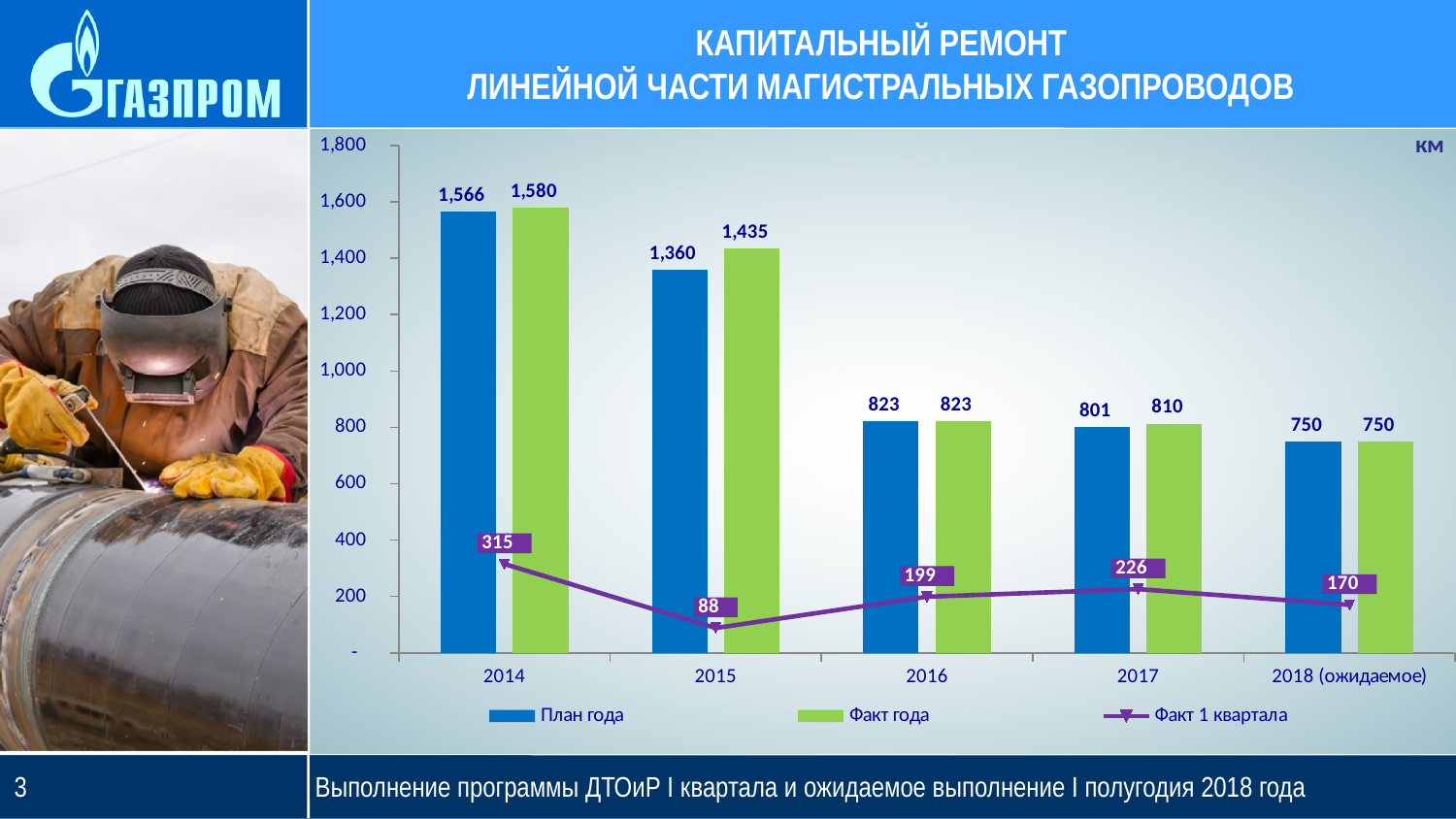
How many years are shown on the x axis? 5 Which is larger for 2017: "План года" or "Факт года"? Факт года What is the difference between "Факт года" and "План года" for 2015? 75 How many series does the legend list? 3 What is the value of "Факт года" for 2015? 1,435 In which year is "Факт 1 квартала" lowest? 2015 What kind of chart is shown on the slide? Combined bar and line chart What is the value of "План года" for 2014? 1,566 In which year is "Факт года" highest? 2014 Is the value of "План года" for 2016 greater or less than 1,000? less What is the value of "Факт 1 квартала" for 2017? 226 What unit is indicated in the top right corner of the chart? км